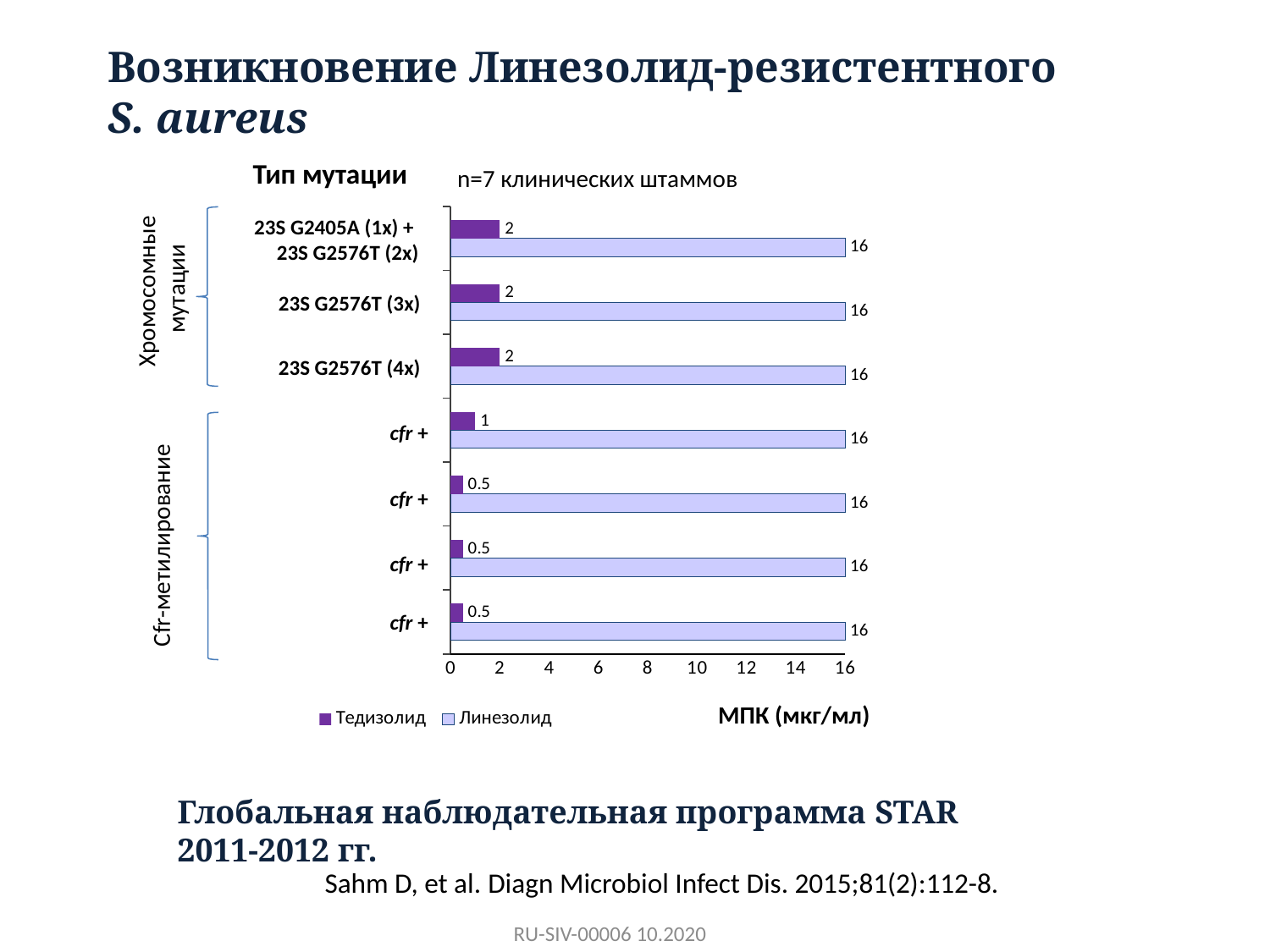
What is the Тедизолид value for the category 23S G2405A (1x) + 23S G2576T (2x)? 2 What is the Линезолид value for 23S G2576T (4x)? 16 Which is larger for 23S G2576T (4x): the Тедизолид value or the Линезолид value? Линезолид What kind of chart is shown on the slide? bar chart What is the Тедизолид value for the bottom cfr + category? 0.5 How many series does the chart legend list? 2 Which series is shown in dark purple in the legend? Тедизолид What is the label of the x axis of the chart? МПК (мкг/мл) What is the Тедизолид value for 23S G2576T (3x)? 2 What is the difference between the Линезолид and Тедизолид values for 23S G2576T (3x)? 14 How many mutation-type categories are plotted on the chart? 7 What is the Тедизолид value for the topmost cfr + category (the fourth category from the top)? 1